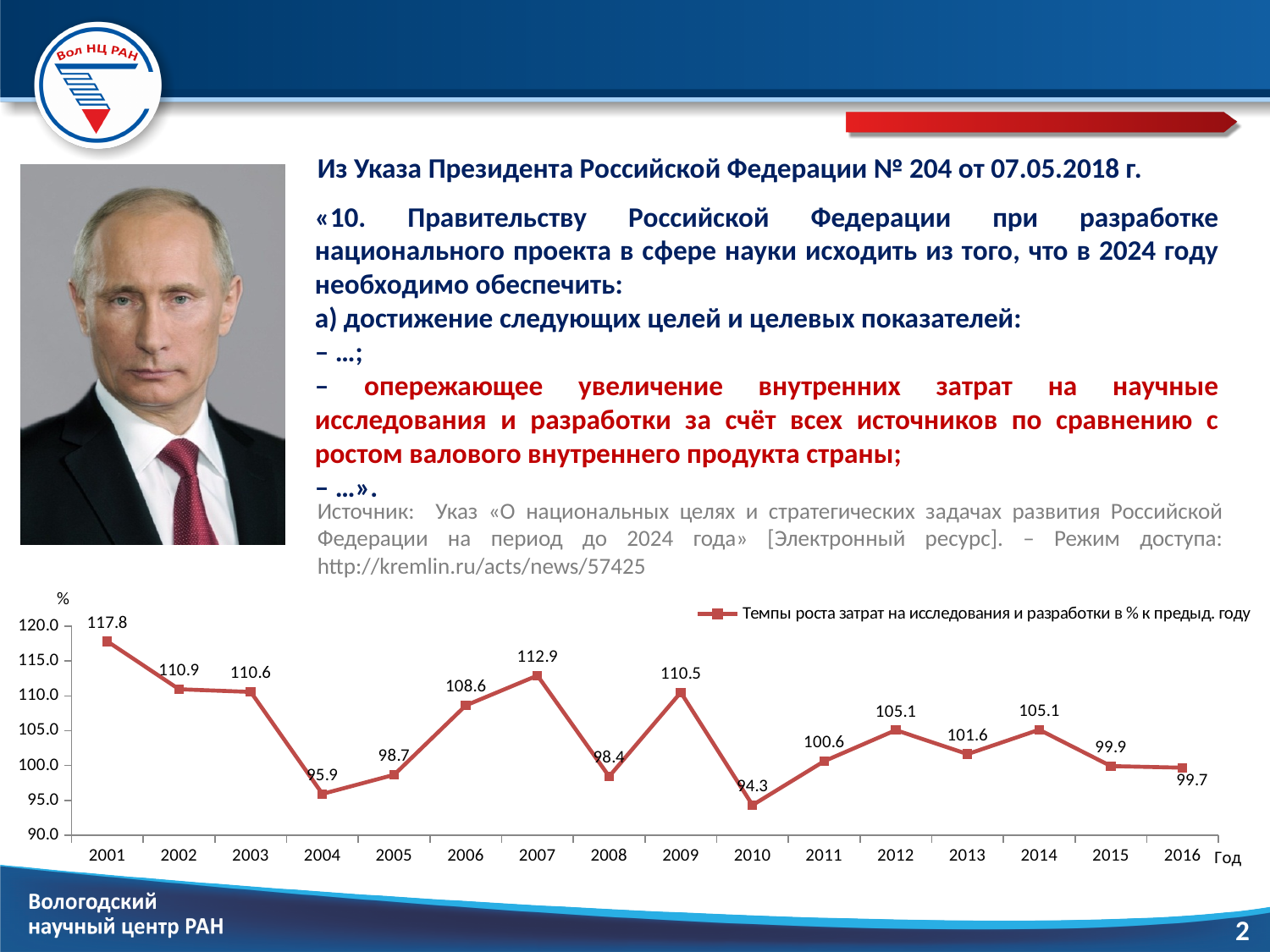
Which year has the lowest value? 2010 What is the difference between the values for 2007 and 2008? 14.5 What type of chart is shown on the slide? Line chart What is the value for 2001? 117.8 How many series does the legend list? 1 What is the value for 2016? 99.7 Is the value for 2004 greater or less than 100.0? less What is the legend entry for the plotted series? Темпы роста затрат на исследования и разработки в % к предыд. году How many years are plotted on the x axis? 16 What is the value for 2010? 94.3 Which is larger, the value for 2006 or the value for 2009? 2009 Which year has the highest value? 2001